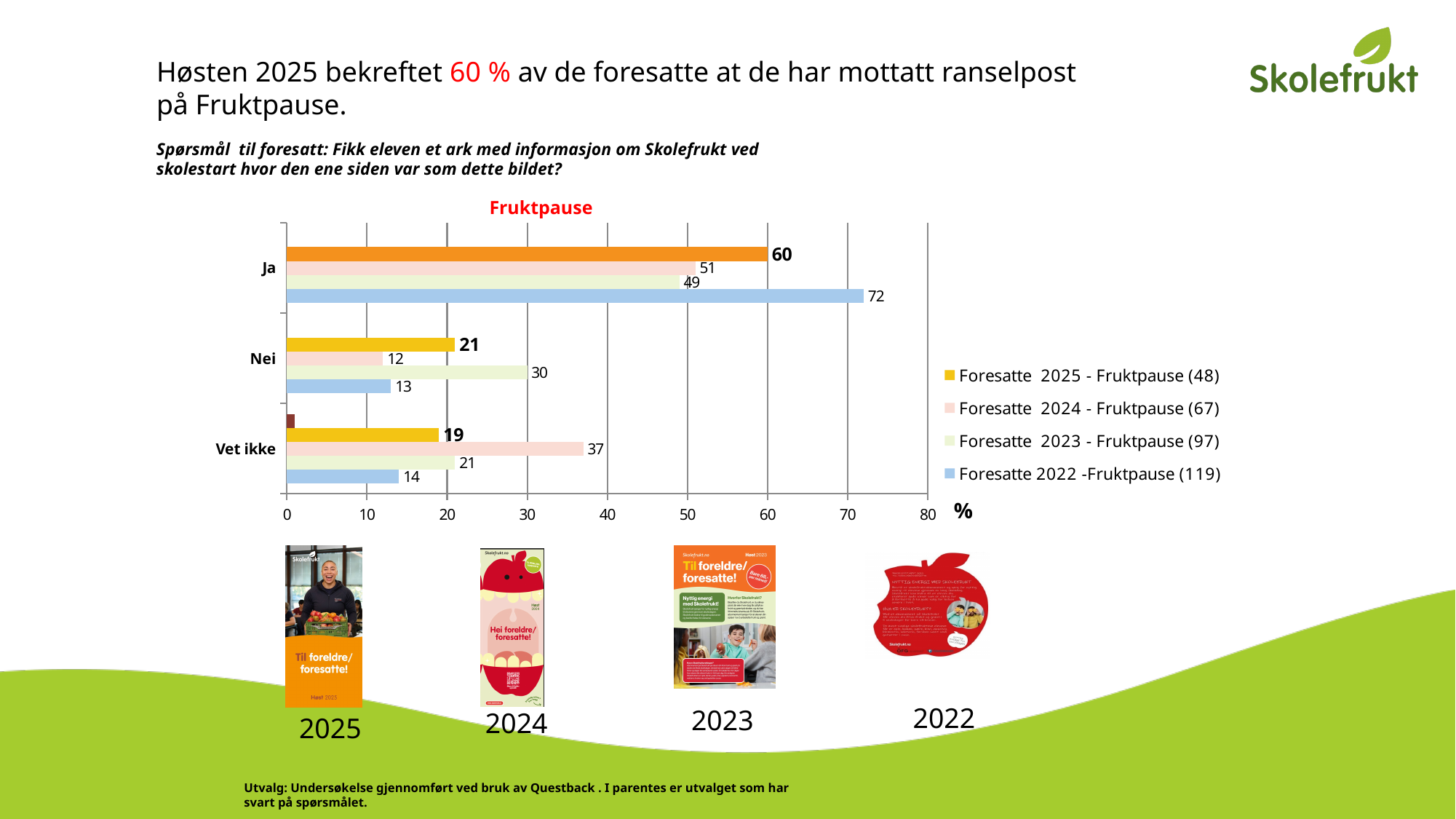
Which series has the lowest value for Nei? Foresatte 2024 - Fruktpause (67) How many categories are shown on the vertical axis of the chart? 3 What is the value for Nei in the Foresatte 2023 - Fruktpause (97) series? 30 What is the value for Vet ikke in the Foresatte 2024 - Fruktpause (67) series? 37 Which is larger: the Vet ikke value for Foresatte 2024 - Fruktpause (67) or for Foresatte 2023 - Fruktpause (97)? Foresatte 2024 - Fruktpause (67) What is the value for Ja in the Foresatte 2022 -Fruktpause (119) series? 72 How many series does the legend list? 4 What is the value for Ja in the Foresatte 2025 - Fruktpause (48) series? 60 What is the difference between the Ja values for Foresatte 2022 -Fruktpause (119) and Foresatte 2025 - Fruktpause (48)? 12 What is the title of the chart? Fruktpause Which series has the highest value for Ja? Foresatte 2022 -Fruktpause (119) What kind of chart is shown on the slide? Bar chart